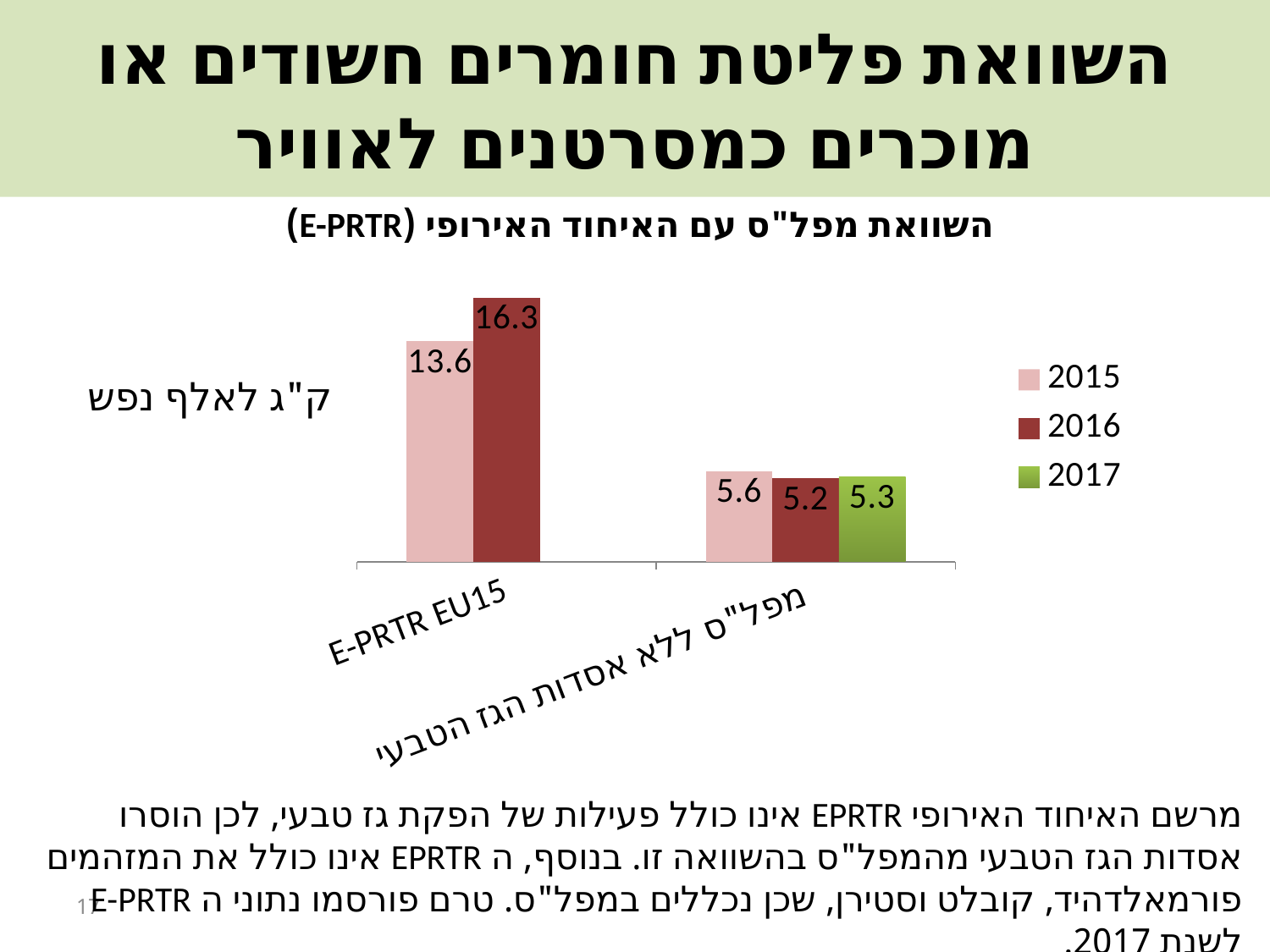
What is the 2016 value for E-PRTR EU15? 16.3 What is the difference between the 2016 and 2015 values for E-PRTR EU15? 2.7 Which is larger: the 2015 value for E-PRTR EU15 or the 2015 value for מפל"ס ללא אסדות הגז הטבעי? E-PRTR EU15 What is the 2017 value for מפל"ס ללא אסדות הגז הטבעי? 5.3 What is the 2015 value for E-PRTR EU15? 13.6 What is the 2016 value for מפל"ס ללא אסדות הגז הטבעי? 5.2 Which year has the highest value for E-PRTR EU15? 2016 What kind of chart is shown on the slide? Bar chart Which year has the lowest value for מפל"ס ללא אסדות הגז הטבעי? 2016 How many categories are shown on the x axis? 2 How many series does the legend list? 3 What is the unit label shown on the vertical axis of the chart? ק"ג לאלף נפש